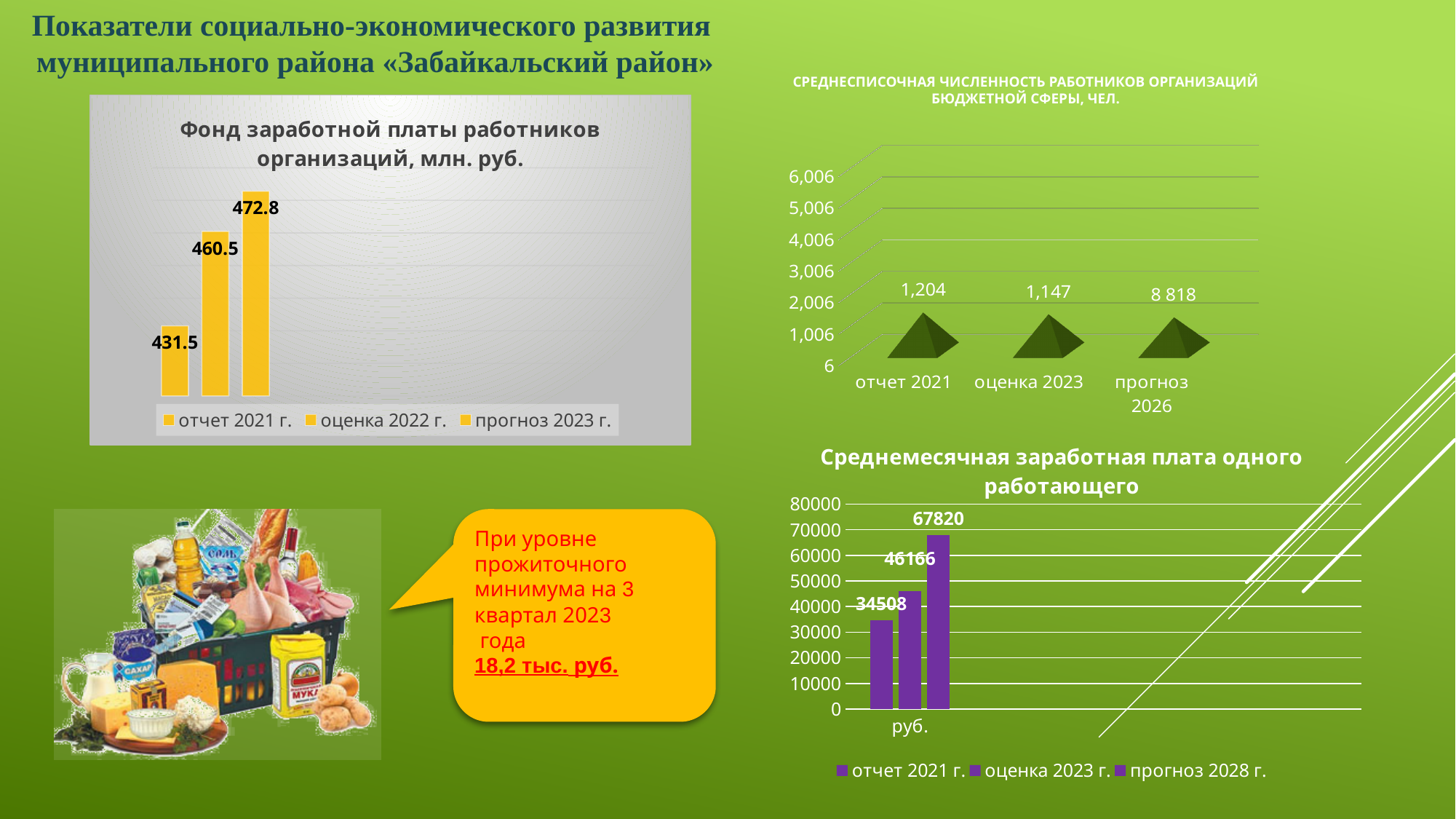
What type of chart is 'Фонд заработной платы работников организаций, млн. руб.'? bar chart In the chart 'Фонд заработной платы работников организаций, млн. руб.', which series has the lowest value? отчет 2021 г. In the chart 'Среднесписочная численность работников организаций бюджетной сферы, чел.', what is the value for 'отчет 2021'? 1,204 How many categories are shown in the chart 'Среднесписочная численность работников организаций бюджетной сферы, чел.'? 3 In the chart 'Среднесписочная численность работников организаций бюджетной сферы, чел.', what is the value for 'оценка 2023'? 1,147 In the chart 'Среднемесячная заработная плата одного работающего', which series has the highest value? прогноз 2028 г. In the chart 'Среднемесячная заработная плата одного работающего', what is the value for 'оценка 2023 г.'? 46166 In the chart 'Фонд заработной платы работников организаций, млн. руб.', do the values rise or fall from 'отчет 2021 г.' to 'прогноз 2023 г.'? rise In the chart 'Среднемесячная заработная плата одного работающего', what is the difference between 'прогноз 2028 г.' and 'отчет 2021 г.'? 33312 In the chart 'Фонд заработной платы работников организаций, млн. руб.', what is the value for 'отчет 2021 г.'? 431.5 In the chart 'Фонд заработной платы работников организаций, млн. руб.', what is the difference between 'прогноз 2023 г.' and 'оценка 2022 г.'? 12.3 In the chart 'Фонд заработной платы работников организаций, млн. руб.', what is the value for 'прогноз 2023 г.'? 472.8